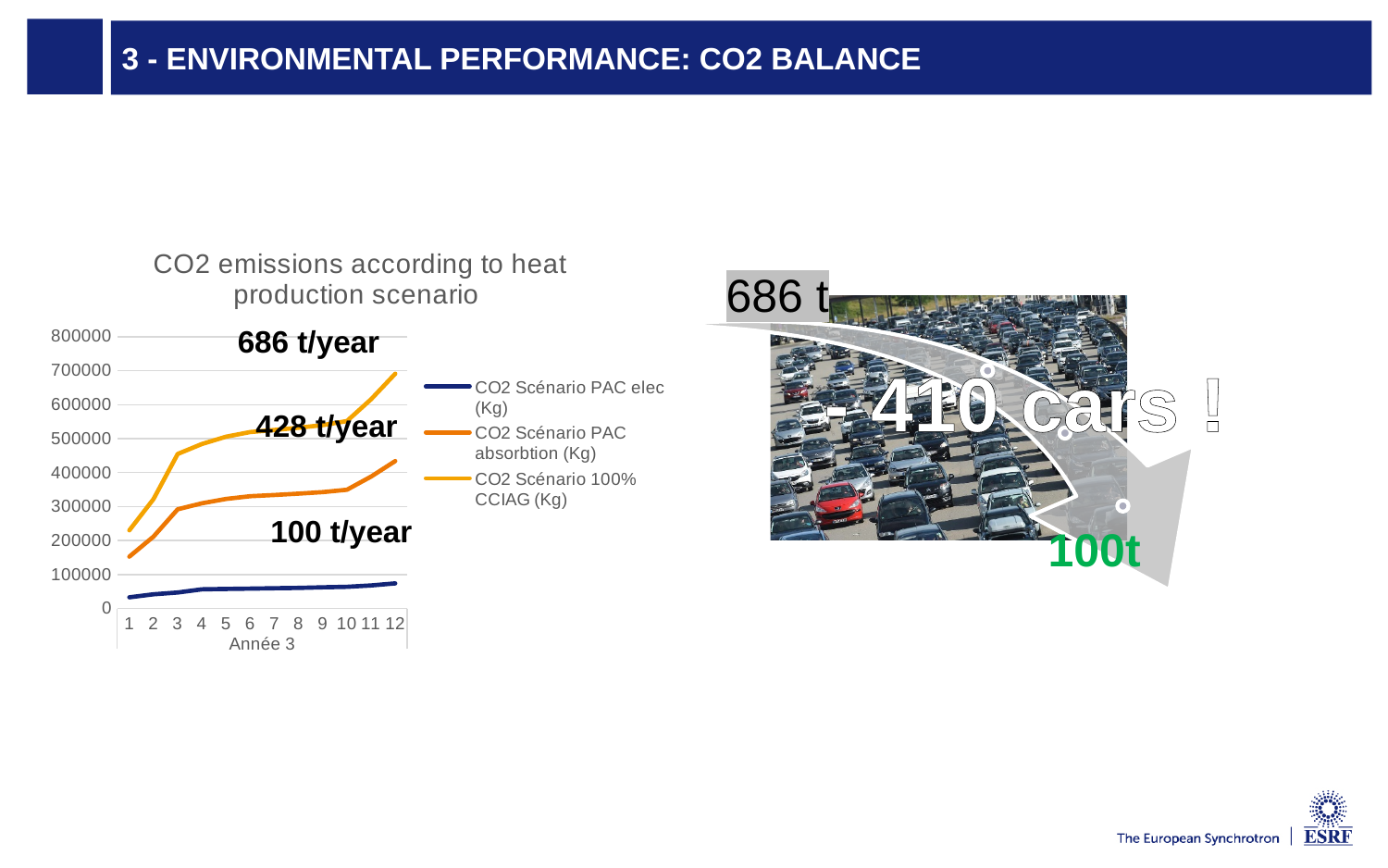
Do the values of the CO2 Scénario 100% CCIAG (Kg) series rise or fall from point 1 to point 12? rise Is the value for CO2 Scénario 100% CCIAG (Kg) at point 12 greater or less than 600000? greater Which series has the lowest values across the chart? CO2 Scénario PAC elec (Kg) Which series has the highest value at point 12? CO2 Scénario 100% CCIAG (Kg) Is the value for CO2 Scénario PAC elec (Kg) at point 12 greater or less than 100000? less What kind of chart is shown on the slide? line chart Which is larger at point 6: CO2 Scénario PAC absorbtion (Kg) or CO2 Scénario PAC elec (Kg)? CO2 Scénario PAC absorbtion (Kg) What is the x-axis label of the chart? Année 3 What is the title of the chart? CO2 emissions according to heat production scenario How many series does the chart legend list? 3 How many points are plotted along the x axis of the chart? 12 What annual total is annotated on the chart for the lowest line? 100 t/year